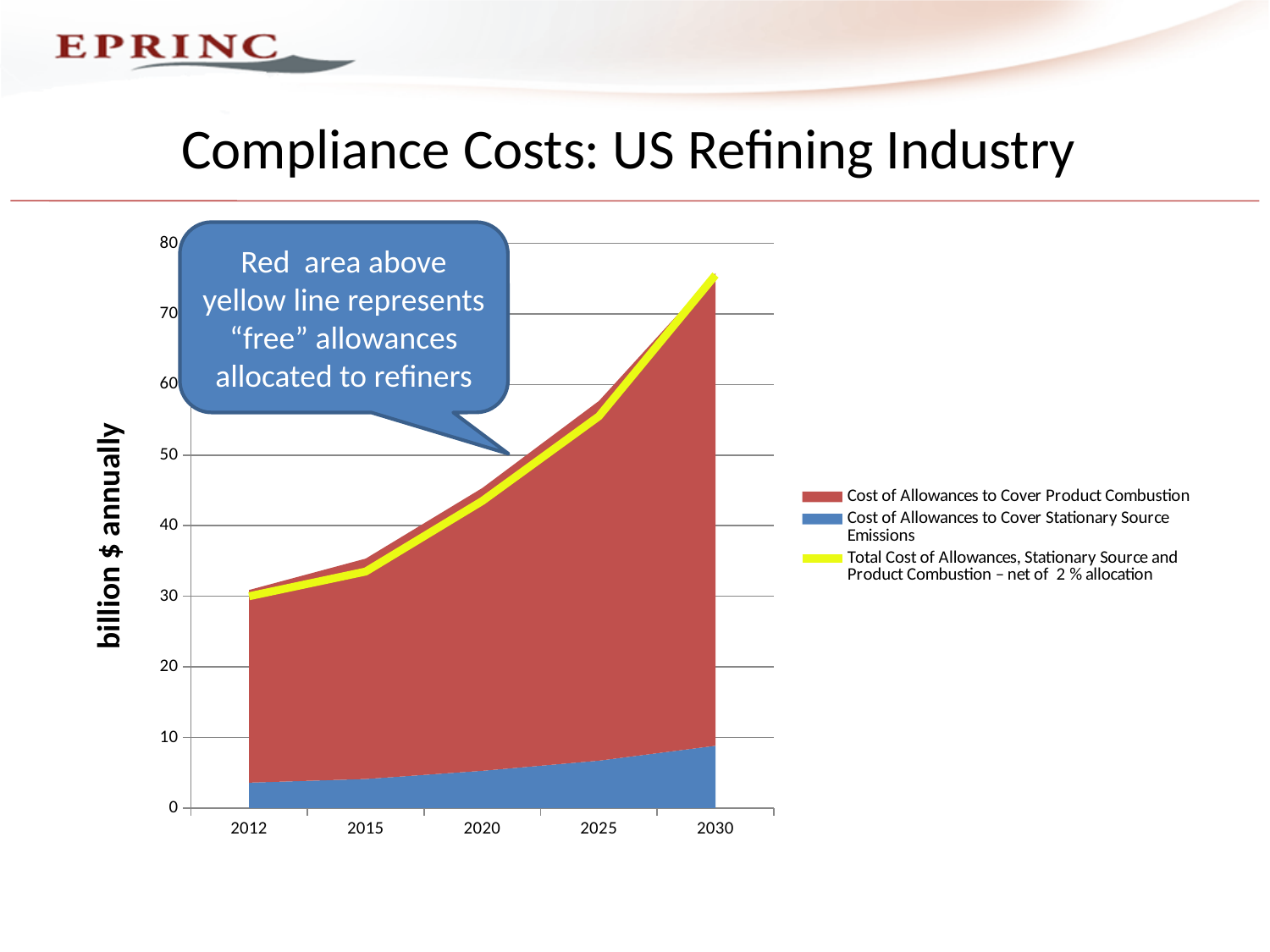
Do the total compliance costs rise or fall from 2012 to 2030? Rise What kind of chart is shown on the slide? Area chart How many years are shown on the x axis of the chart? 5 Is the total cost of allowances in 2015 greater or less than 40 billion $ annually? less Is the cost of allowances to cover stationary source emissions in 2030 greater or less than 10 billion $ annually? less In 2030, which is larger: the cost of allowances to cover product combustion or the cost of allowances to cover stationary source emissions? Cost of Allowances to Cover Product Combustion Which year has a larger total cost of allowances, 2015 or 2025? 2025 Is the total cost of allowances in 2030 greater or less than 70 billion $ annually? greater What is the label on the y axis of the chart? billion $ annually In which year is the total cost of allowances highest? 2030 How many series does the chart's legend list? 3 In which year is the total cost of allowances lowest? 2012